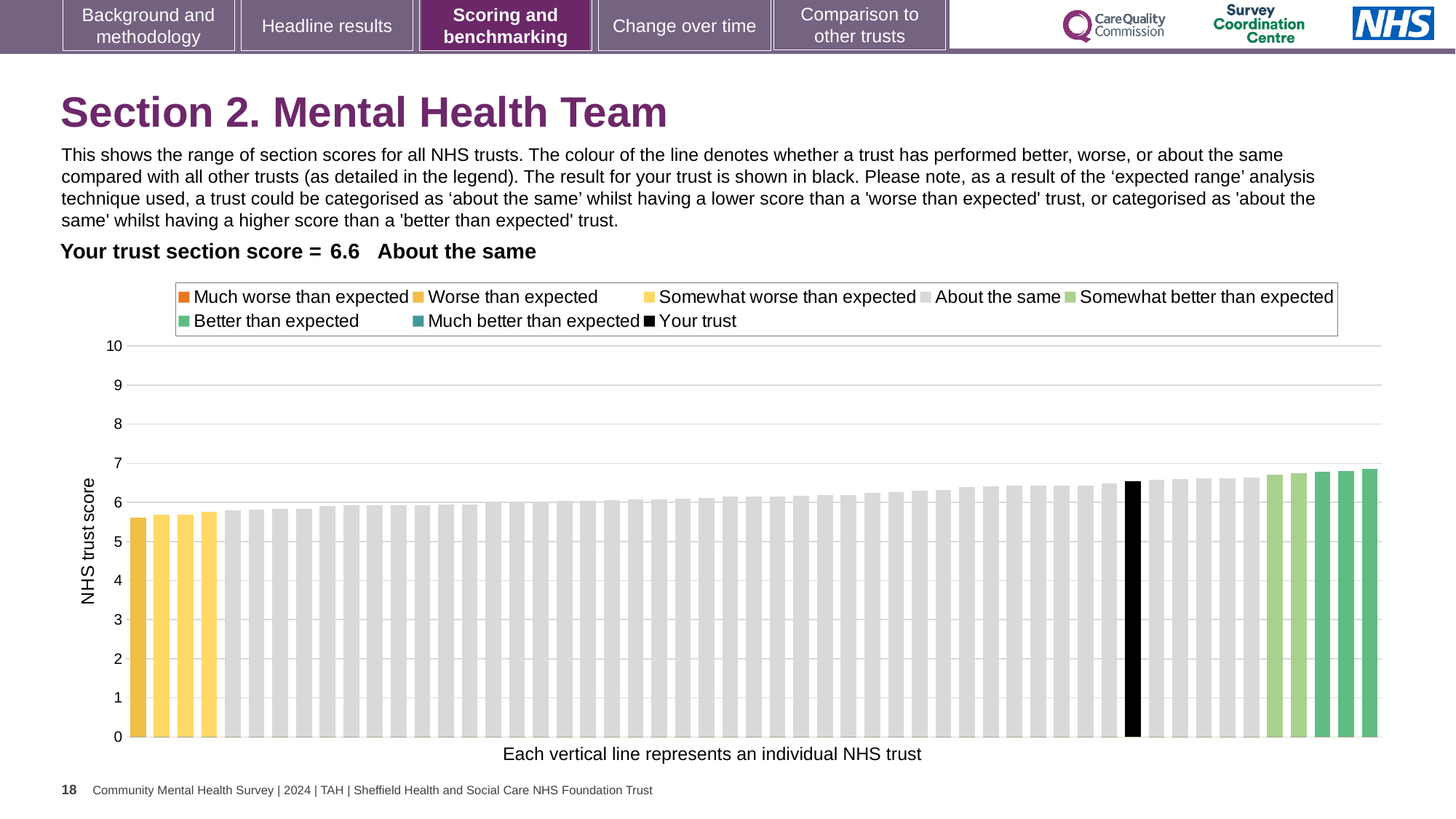
Which performance category is your trust placed in for this section? About the same Is the value of the black bar (your trust) greater or less than 6? greater How many entries does the chart legend list? 8 Is the value of the highest bar greater or less than 7? less According to the x-axis caption, what does each vertical line represent? An individual NHS trust Is the value of the black bar (your trust) greater or less than 7? less What is the maximum value shown on the y axis? 10 Do the bar values rise or fall from left to right along the x axis? rise What kind of chart is shown on the slide? bar chart What is the section score for your trust? 6.6 What is the label on the y axis? NHS trust score